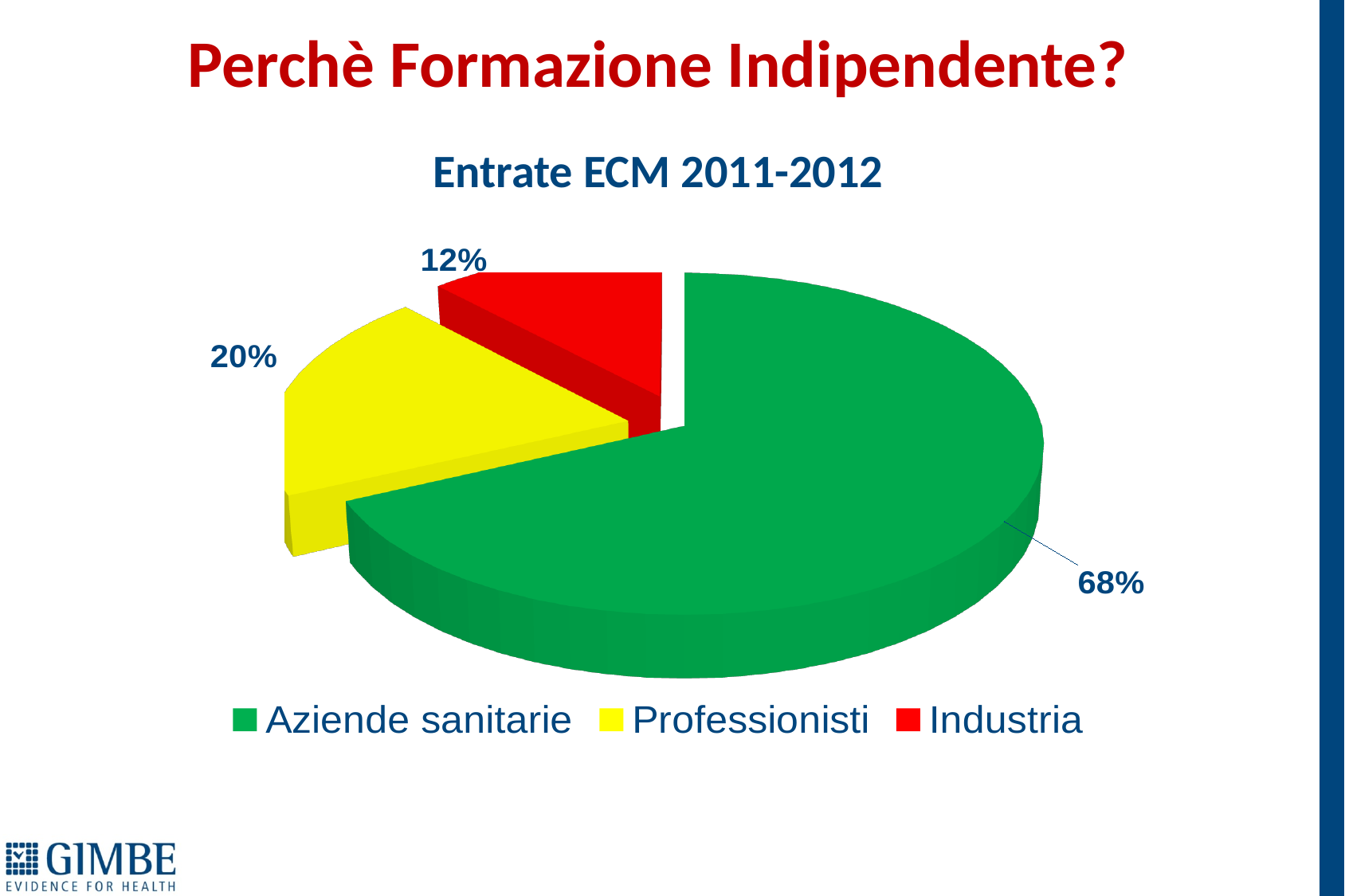
What share of the pie does Aziende sanitarie hold? 68% Which colour represents Industria in the legend? Red What is the title of the chart? Entrate ECM 2011-2012 Which is larger, the share for Professionisti or the share for Industria? Professionisti Which category has the smallest slice of the pie? Industria Which category has the largest slice of the pie? Aziende sanitarie What share of the pie does Professionisti hold? 20% How many slices does the pie chart have? 3 What kind of chart is shown on the slide? Pie chart What is the difference in percentage points between Aziende sanitarie and Professionisti? 48 What share of the pie does Industria hold? 12% What is the difference in percentage points between Professionisti and Industria? 8